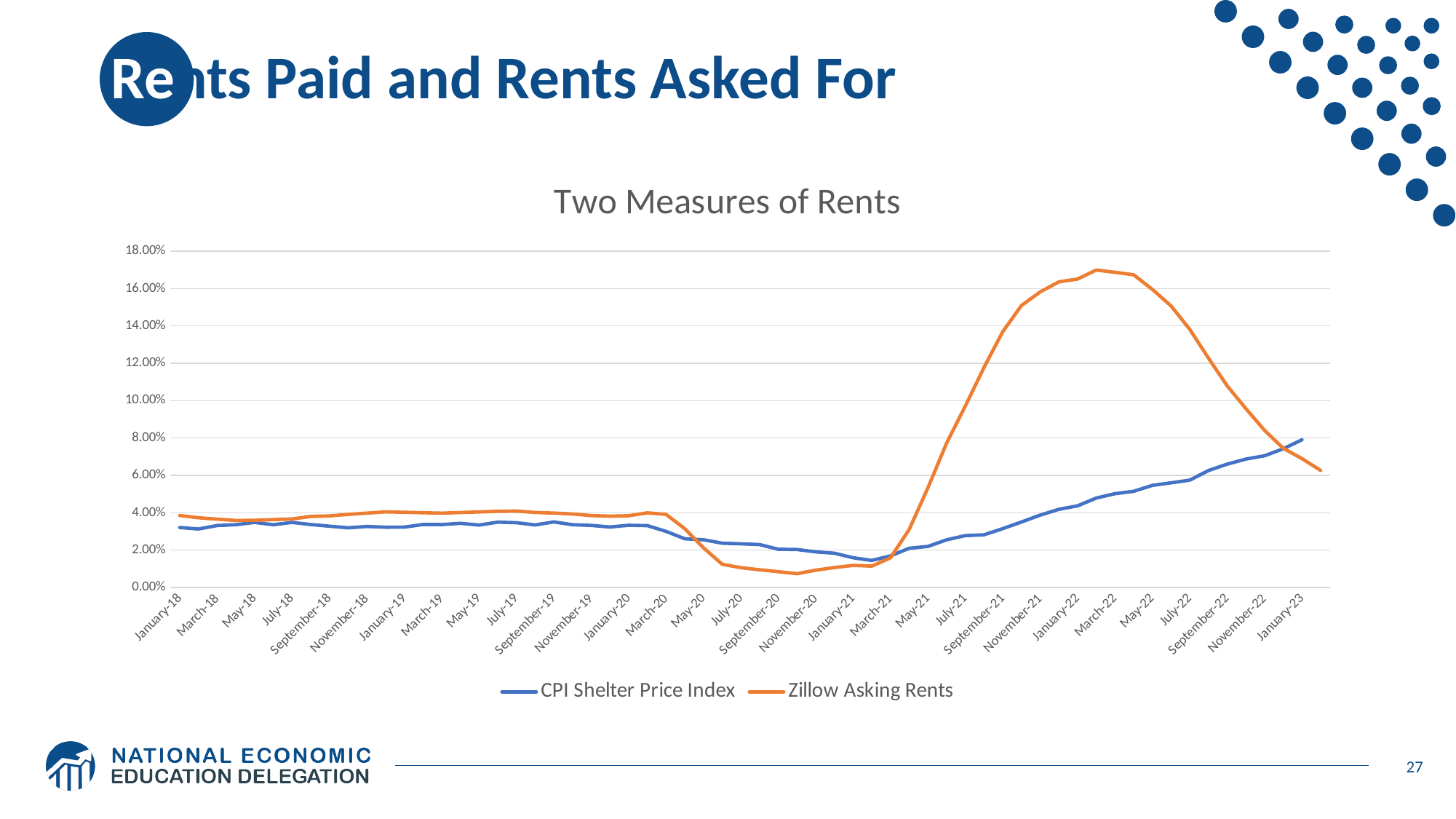
What kind of chart is shown on the slide? Line chart In March-22, which series has the higher value, CPI Shelter Price Index or Zillow Asking Rents? Zillow Asking Rents Is the value for CPI Shelter Price Index in January-23 greater or less than 6.00%? greater Does the CPI Shelter Price Index line rise or fall between March-21 and January-23? Rise Which colour is used for the Zillow Asking Rents line? Orange Is the value for Zillow Asking Rents in September-20 greater or less than 2.00%? less How many series does the legend of the chart list? 2 What is the title of the chart? Two Measures of Rents Does the Zillow Asking Rents line rise or fall between March-22 and January-23? Fall Is the value for Zillow Asking Rents in March-22 greater or less than 16.00%? greater In January-23, which series has the higher value, CPI Shelter Price Index or Zillow Asking Rents? CPI Shelter Price Index